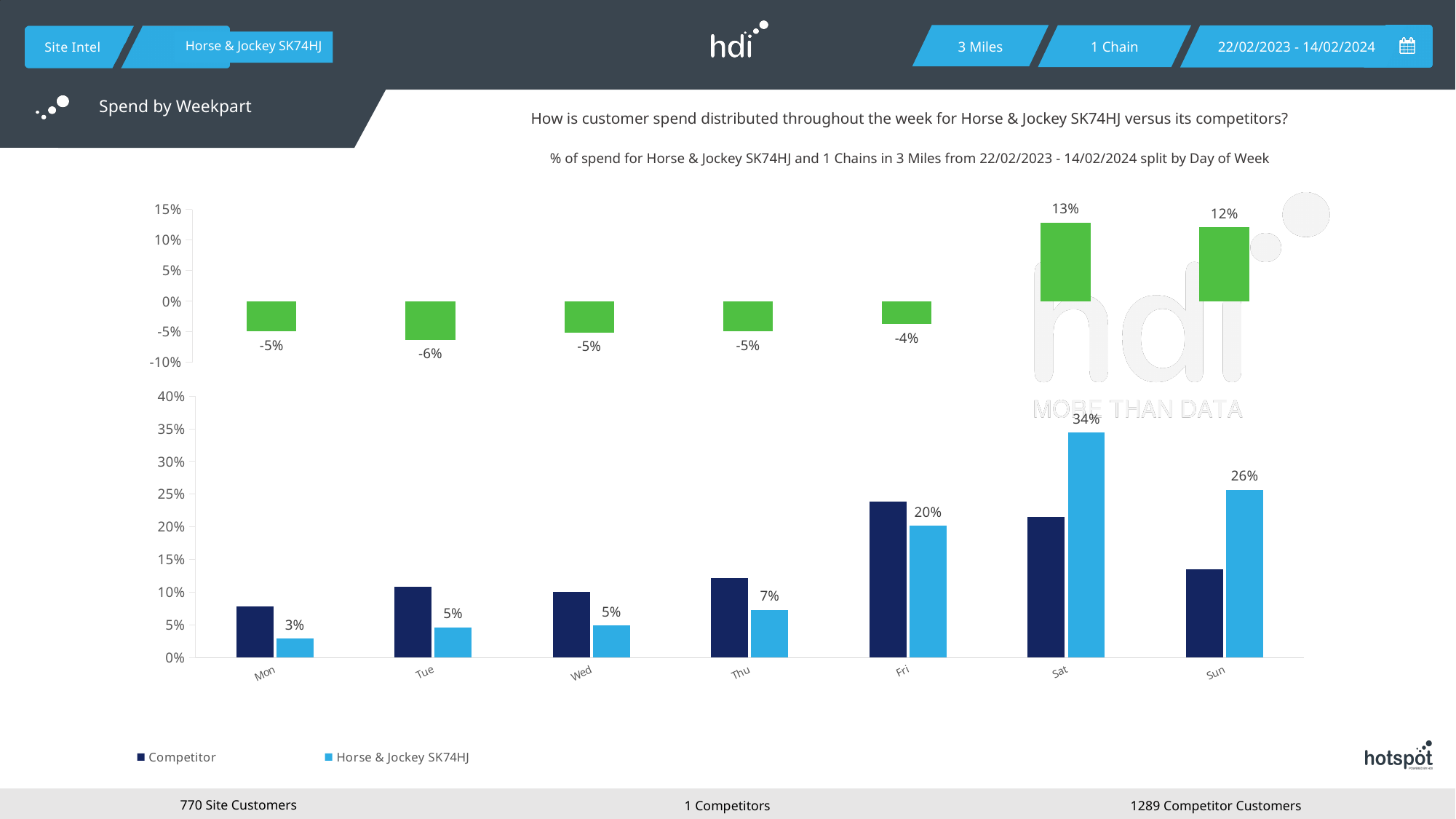
In the bottom chart, which day has the lowest value for Horse & Jockey SK74HJ? Mon In the bottom chart, on Fri, which is larger: the Competitor bar or the Horse & Jockey SK74HJ bar? Competitor In the bottom chart, is the Competitor value for Fri greater or less than 20%? greater In the bottom chart, what is the value for Horse & Jockey SK74HJ on Sat? 34% In the top chart, what is the value shown for Tue? -6% In the bottom chart, is the Competitor value for Mon greater or less than 10%? less In the bottom chart, what is the difference between the Horse & Jockey SK74HJ values for Sat and Sun? 8% In the bottom chart, which day has the highest value for Horse & Jockey SK74HJ? Sat In the top chart, what is the value shown for Sat? 13% In the bottom chart, what is the value for Horse & Jockey SK74HJ on Mon? 3% What kind of chart is the bottom chart? Bar chart How many series does the legend of the bottom chart list? 2